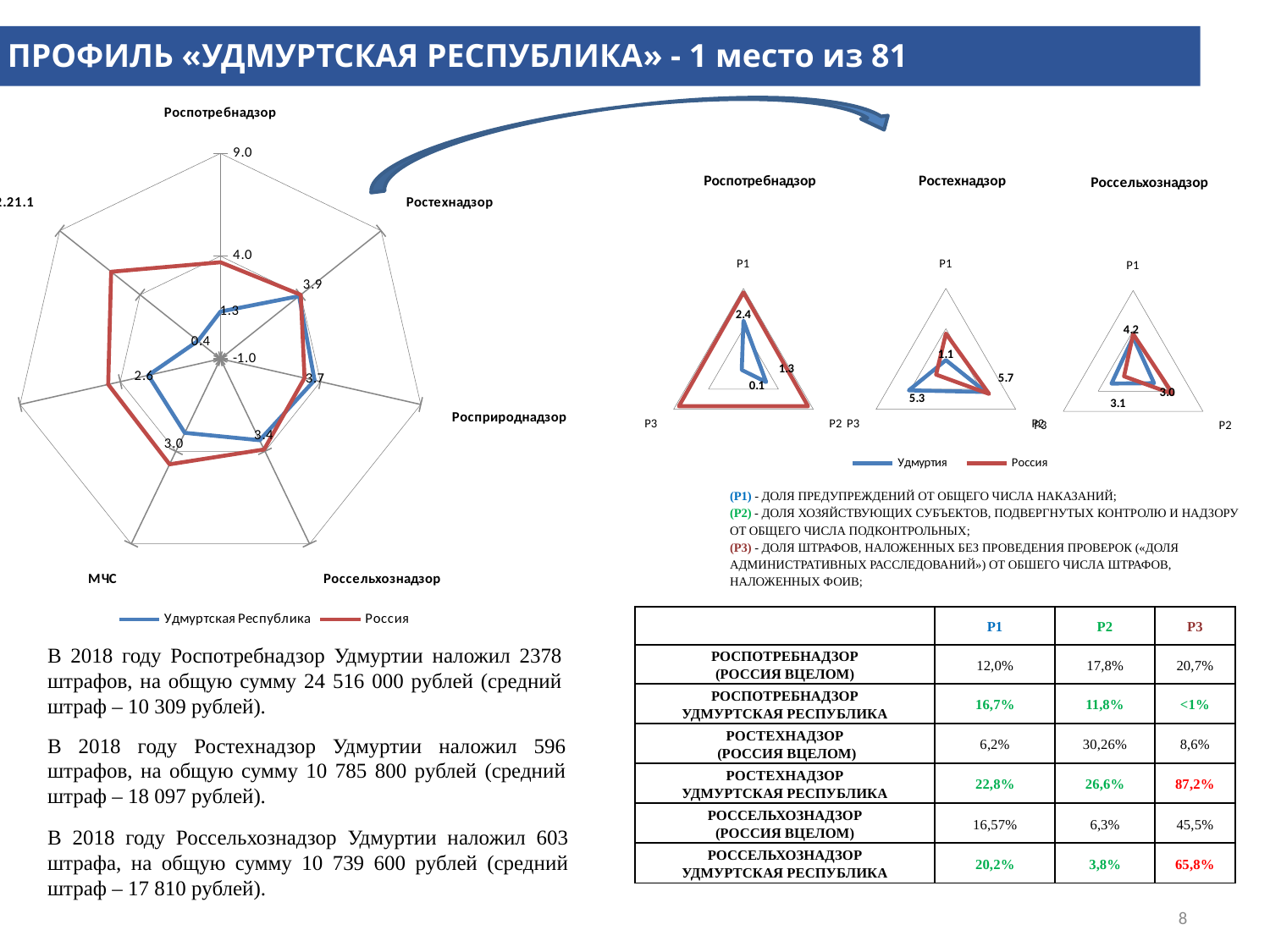
How many series does the legend of the large radar chart on the left list? 2 In the large radar chart on the left, which series is drawn in red? Россия In the large radar chart on the left, what is the difference between the Удмуртская Республика values at Ростехнадзор (3.9) and МЧС (3.0)? 0.9 In the large radar chart on the left, what is the value for Удмуртская Республика at Ростехнадзор? 3.9 In the small Роспотребнадзор radar chart on the right, which axis has the lowest labelled value? P3 In the small Роспотребнадзор radar chart on the right, what is the labelled value at P1? 2.4 In the small Ростехнадзор radar chart on the right, which axis has the highest labelled value? P2 What kind of chart is the large chart on the left of the slide? Radar chart In the large radar chart on the left, what is the value for Удмуртская Республика at МЧС? 3.0 How many axes (points) does each of the small radar charts on the right have? 3 In the large radar chart on the left, at МЧС, which series has the larger value: Удмуртская Республика or Россия? Россия In the large radar chart on the left, is the Удмуртская Республика value at Ростехнадзор greater or less than 4.0? less